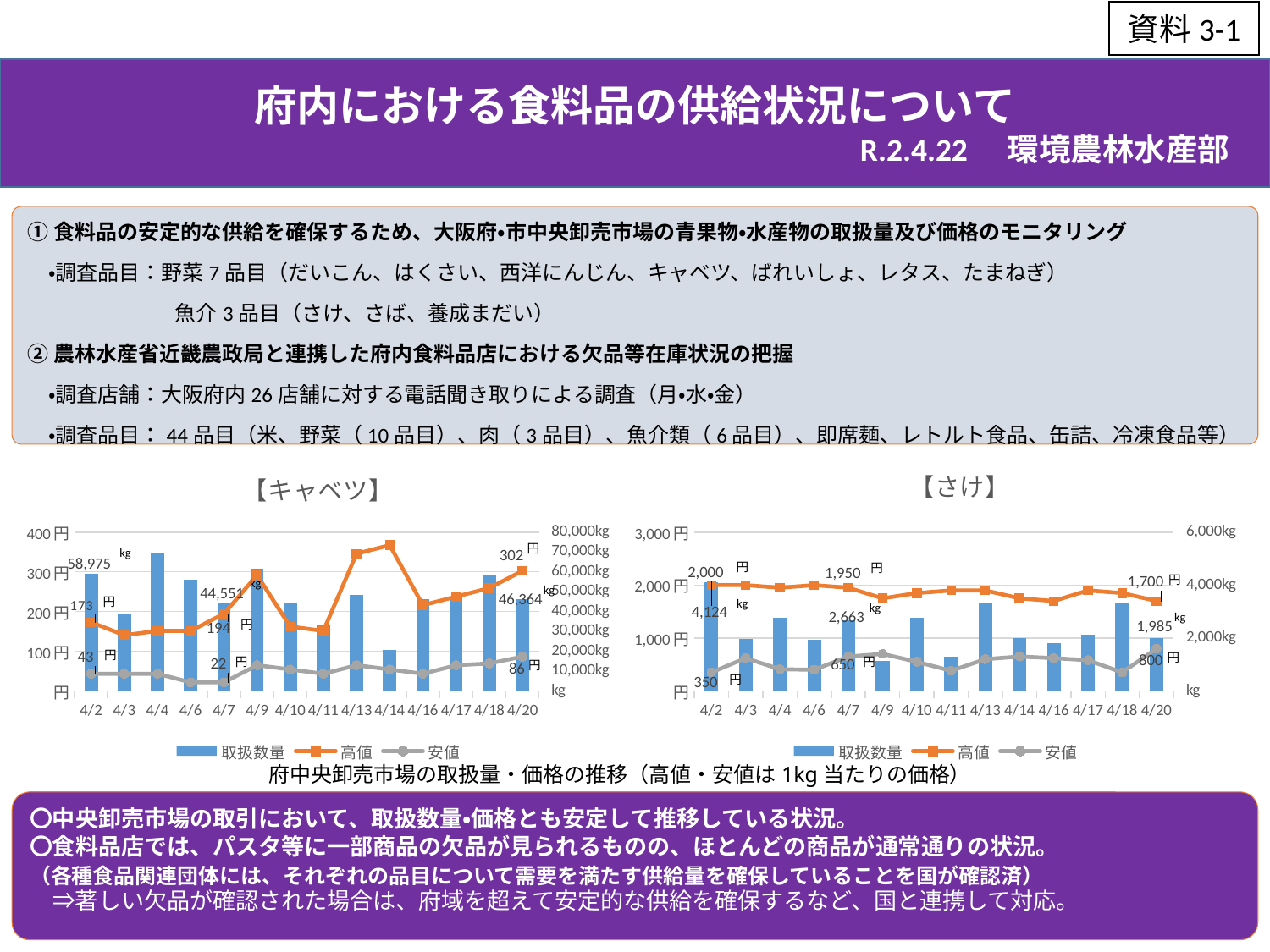
In the 【キャベツ】 chart, how much higher is the 高値 on 4/20 than on 4/2? 129円 How many series does the legend of the 【キャベツ】 chart list? 3 In the 【キャベツ】 chart, what is the 取扱数量 on 4/2? 58,975kg In the 【さけ】 chart, what is the 高値 on 4/2? 2,000円 In the 【さけ】 chart, what is the difference between the 安値 on 4/20 and on 4/2? 450円 How many dates are shown on the x axis of the 【さけ】 chart? 14 In the 【キャベツ】 chart, on which date does the 安値 reach its lowest value? 4/6 and 4/7 In the 【キャベツ】 chart, what is the 高値 on 4/20? 302円 In the 【さけ】 chart, what is the 取扱数量 on 4/20? 1,985kg In the 【キャベツ】 chart, is the 取扱数量 on 4/4 greater or less than 60,000kg? greater In the 【キャベツ】 chart, on which date does the 高値 line reach its highest point? 4/14 In the 【キャベツ】 chart, which date has the larger 取扱数量, 4/2 or 4/20? 4/2